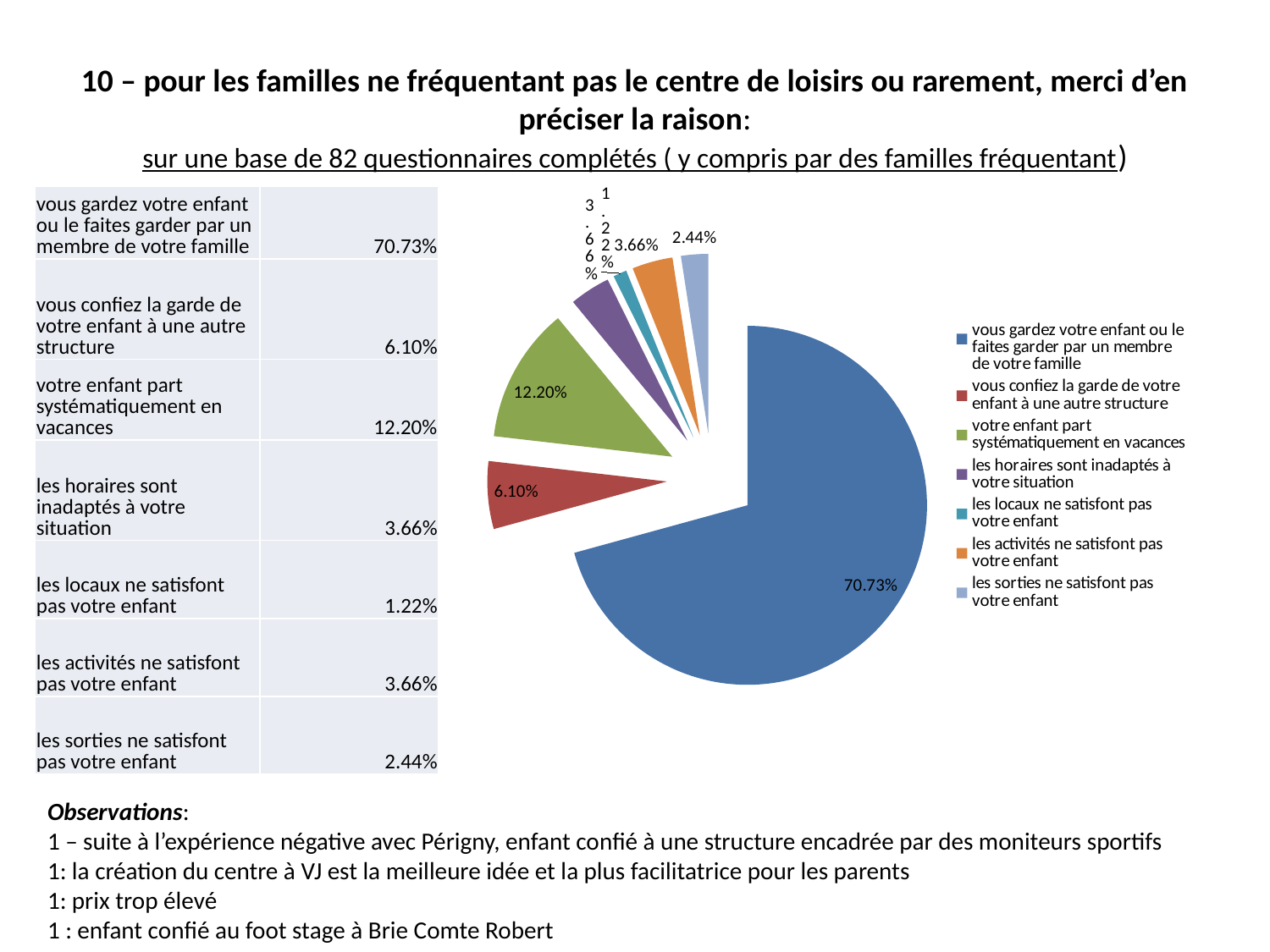
What is the value for 'les sorties ne satisfont pas votre enfant'? 2.44% Which category has the largest slice of the pie? vous gardez votre enfant ou le faites garder par un membre de votre famille What colour is the largest slice of the pie chart? blue What is the difference between the values for 'votre enfant part systématiquement en vacances' and 'vous confiez la garde de votre enfant à une autre structure'? 6.10% What share of the pie is 'vous gardez votre enfant ou le faites garder par un membre de votre famille'? 70.73% What is the value for 'votre enfant part systématiquement en vacances'? 12.20% How many entries does the legend of the pie chart list? 7 What is the value for 'vous confiez la garde de votre enfant à une autre structure'? 6.10% What kind of chart is shown on the slide? pie chart Which is larger: the value for 'les sorties ne satisfont pas votre enfant' or the value for 'les activités ne satisfont pas votre enfant'? les activités ne satisfont pas votre enfant How many slices does the pie chart have? 7 Which category has the smallest slice of the pie? les locaux ne satisfont pas votre enfant